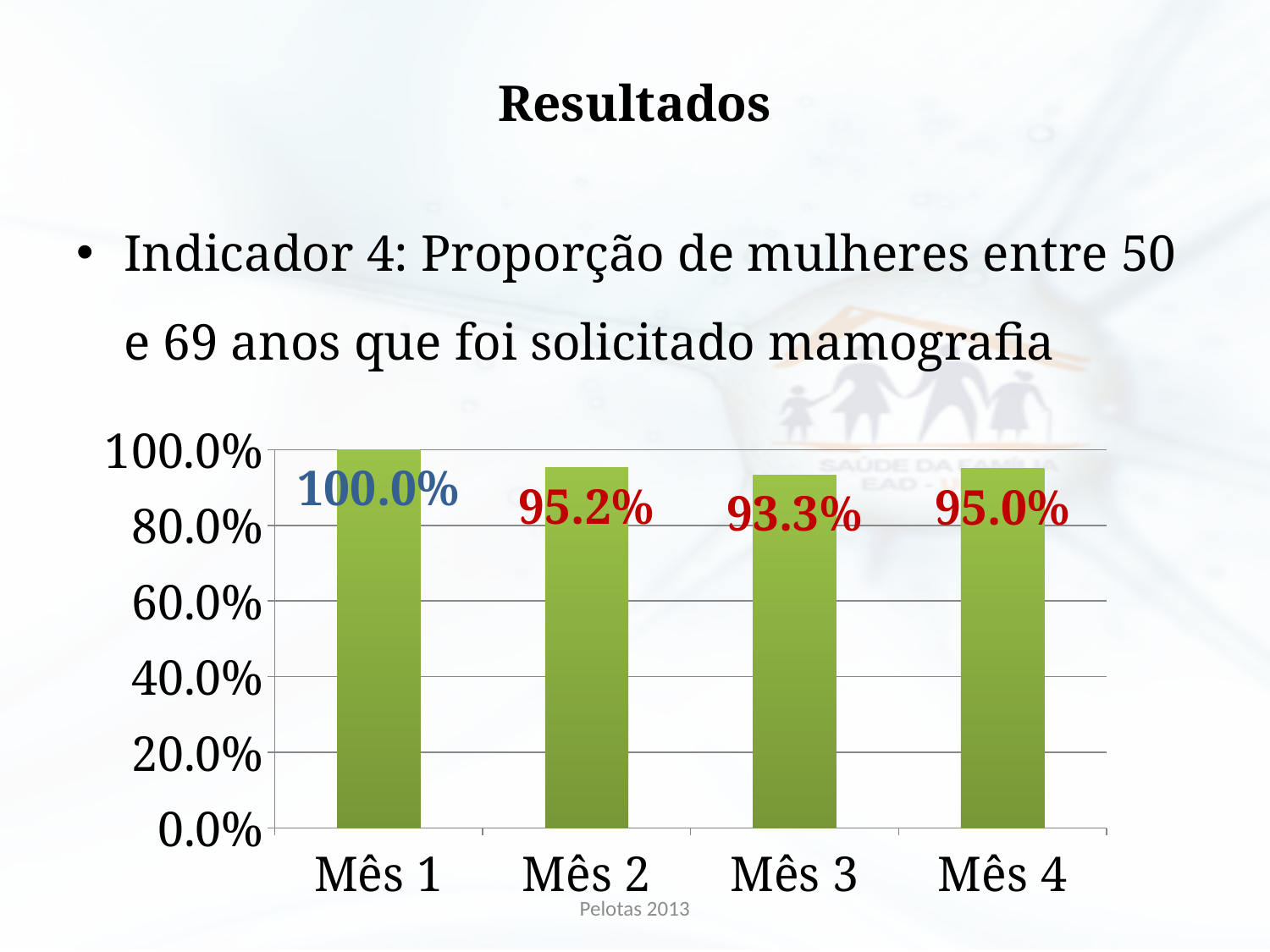
What is the value for Mês 1? 100.0% Which is larger, the value for Mês 2 or the value for Mês 3? Mês 2 Which month has the lowest value? Mês 3 How many months are shown on the x axis? 4 Which month has the highest value? Mês 1 What is the value for Mês 2? 95.2% What is the difference between the values for Mês 1 and Mês 3? 6.7% Is the value for Mês 3 greater or less than 80.0%? greater What is the value for Mês 3? 93.3% What is the value for Mês 4? 95.0% What is the difference between the values for Mês 2 and Mês 4? 0.2% What kind of chart is shown on the slide? bar chart